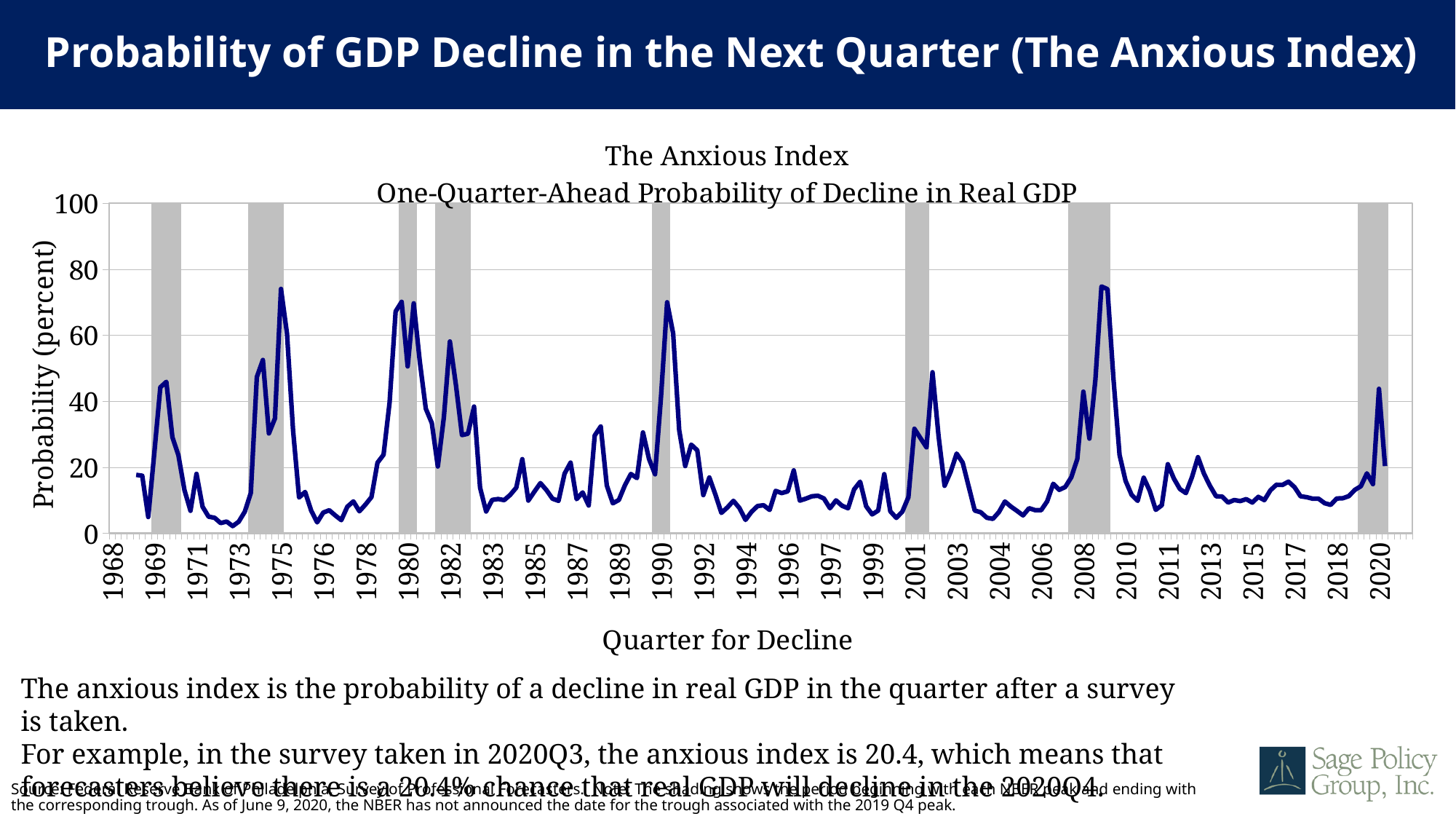
What is the title printed above the chart? The Anxious Index One-Quarter-Ahead Probability of Decline in Real GDP Is the peak of the anxious index around 1975 higher or lower than the peak around 2001? higher What is the label on the vertical axis of the chart? Probability (percent) What kind of chart is shown on the slide? line chart Is the peak value of the anxious index around 1975 greater or less than 60? greater According to the slide text, what is the anxious index in the survey taken in 2020Q3? 20.4 Is the peak value of the anxious index around 1990 greater or less than 60? greater Is the peak value of the anxious index around 2009 greater or less than 60? greater How many data series are plotted on the chart? 1